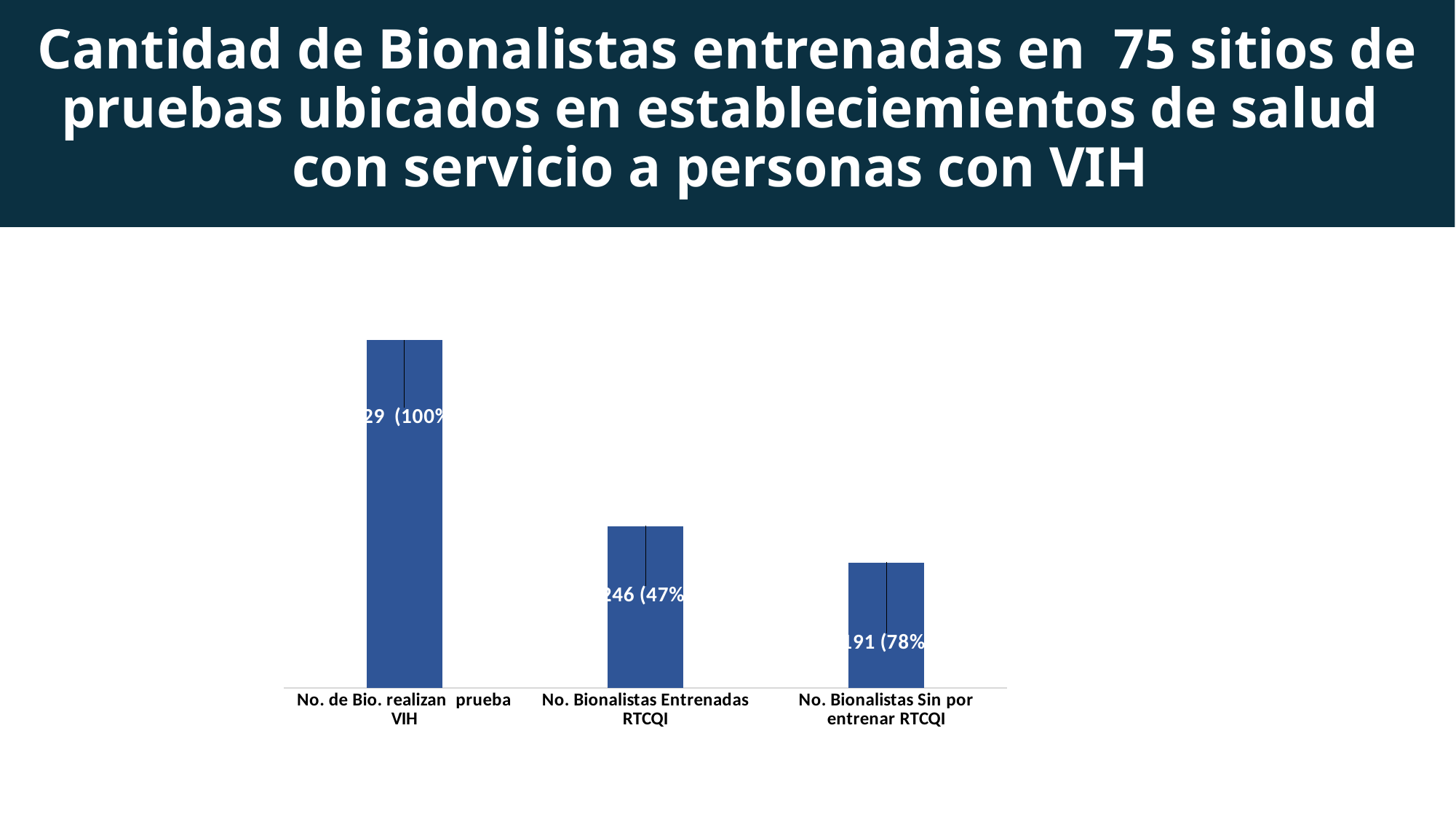
Which category has the tallest bar? No. de Bio. realizan prueba VIH What colour are the bars in the chart? blue What percentage is shown on the bar for No. de Bio. realizan prueba VIH? 100% Which is larger: the bar for No. de Bio. realizan prueba VIH or the bar for No. Bionalistas Entrenadas RTCQI? No. de Bio. realizan prueba VIH What is the title of the slide? Cantidad de Bionalistas entrenadas en 75 sitios de pruebas ubicados en estableciemientos de salud con servicio a personas con VIH What percentage is shown on the bar for No. Bionalistas Sin por entrenar RTCQI? 78% How many bars does the chart show? 3 What kind of chart is shown on the slide? bar chart Which is larger: the bar for No. Bionalistas Entrenadas RTCQI or the bar for No. Bionalistas Sin por entrenar RTCQI? No. Bionalistas Entrenadas RTCQI Which category has the shortest bar? No. Bionalistas Sin por entrenar RTCQI Do the bar heights rise or fall from left to right across the chart? fall What percentage is shown on the bar for No. Bionalistas Entrenadas RTCQI? 47%